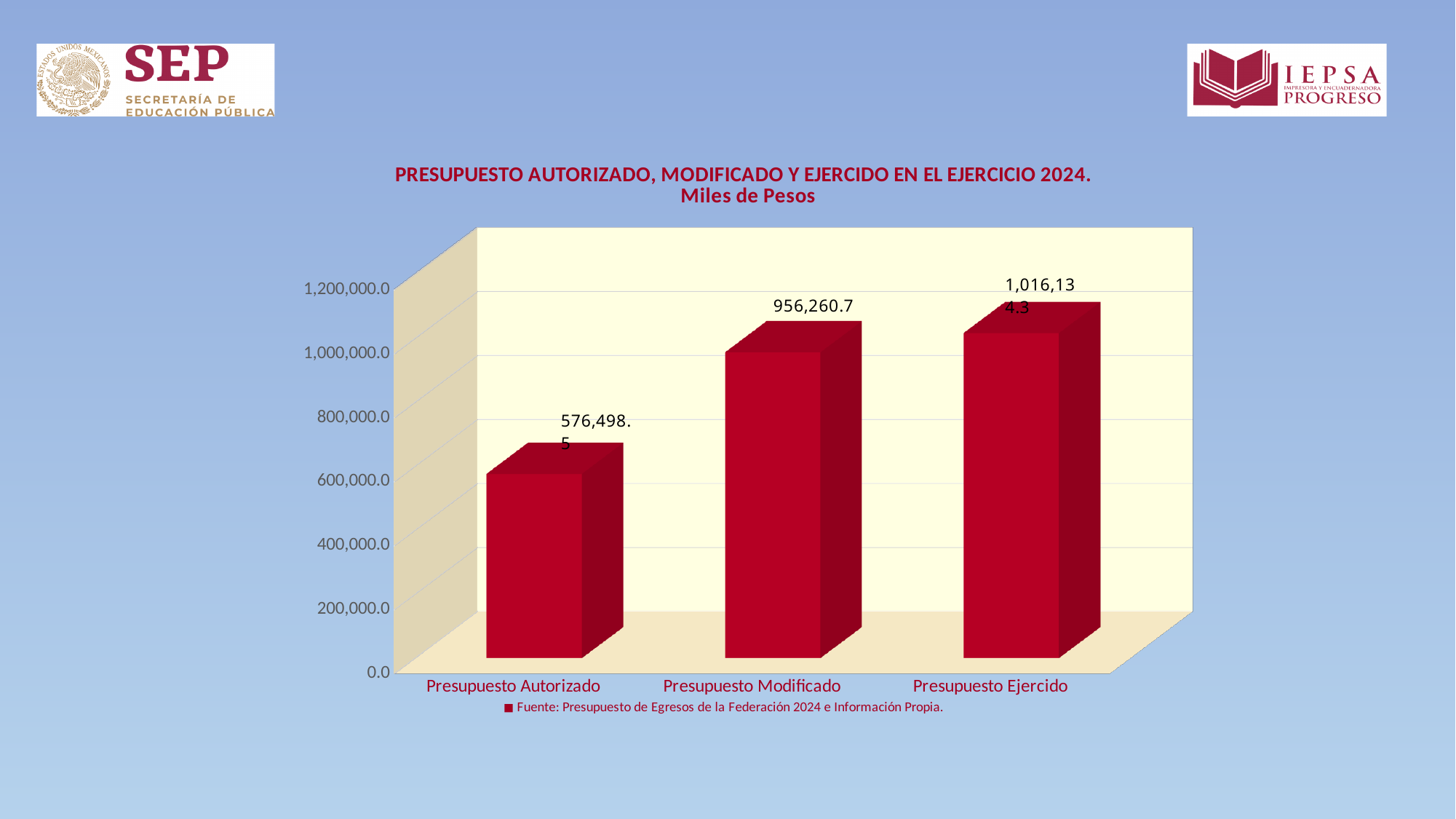
What is the value for Presupuesto Modificado? 956,260.7 How many categories are shown on the x axis? 3 What is the value for Presupuesto Ejercido? 1,016,134.3 What is the difference between Presupuesto Ejercido and Presupuesto Modificado? 59,873.6 Which is larger, Presupuesto Modificado or Presupuesto Autorizado? Presupuesto Modificado What kind of chart is shown on the slide? Bar chart Do the values rise or fall from left to right along the x axis? Rise Which category has the lowest value? Presupuesto Autorizado What is the value for Presupuesto Autorizado? 576,498.5 Which category has the highest value? Presupuesto Ejercido What is the difference between Presupuesto Modificado and Presupuesto Autorizado? 379,762.2 Is the value for Presupuesto Ejercido greater or less than 1,000,000.0? greater